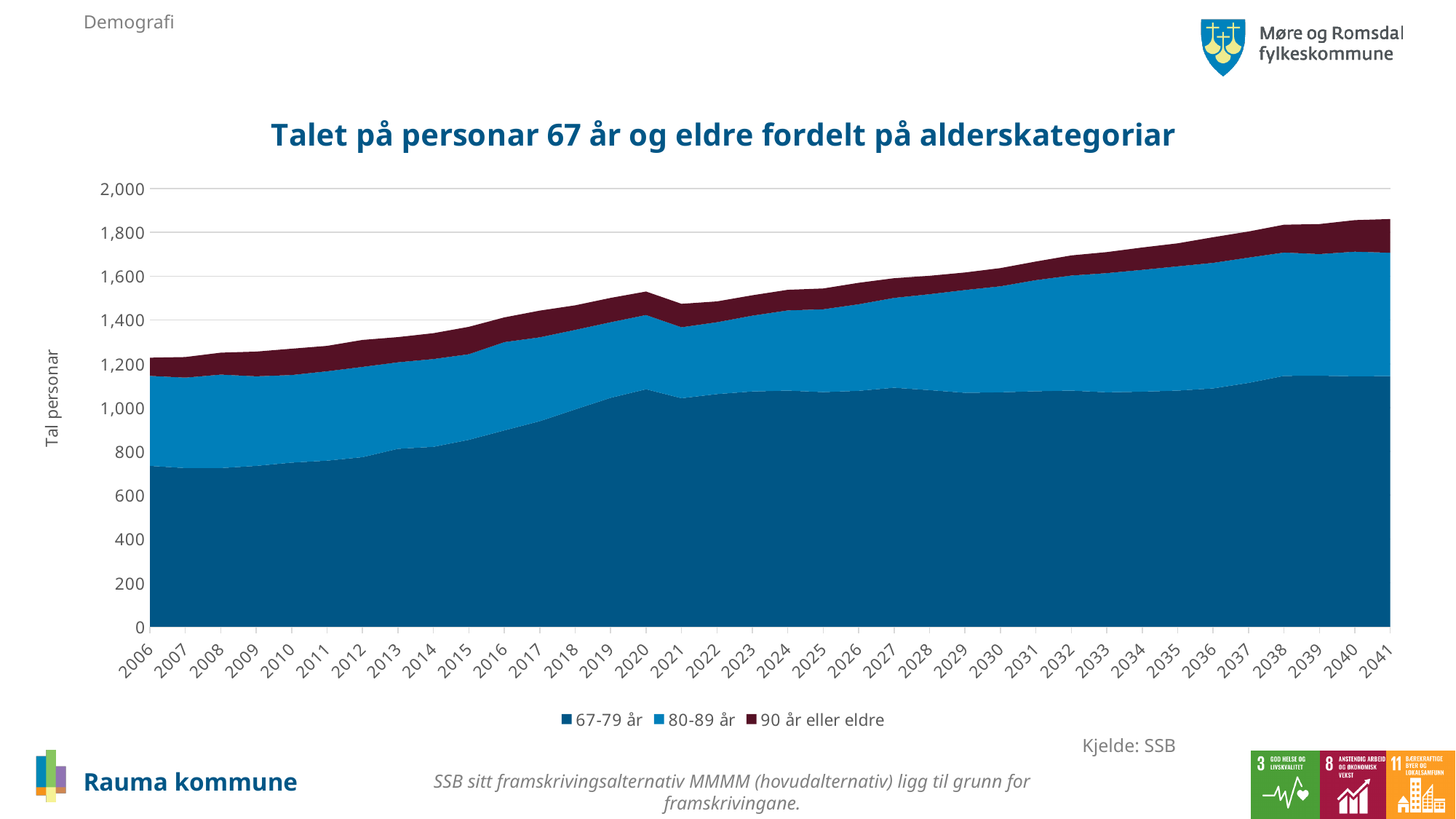
Is the value for 67-79 år in 2006 greater or less than 800? less In which year is the total number of persons 67 år og eldre highest? 2041 What is the title of the chart? Talet på personar 67 år og eldre fordelt på alderskategoriar What is the label on the y axis? Tal personar What kind of chart is shown on the slide? Stacked area chart Is the value for 67-79 år in 2020 greater or less than 1,000? greater How many years are shown along the x axis? 36 Is the total number of persons 67 år og eldre in 2041 greater or less than 1,800? greater How many series does the legend list? 3 Does the total number of persons 67 år og eldre rise or fall from 2006 to 2041? rise